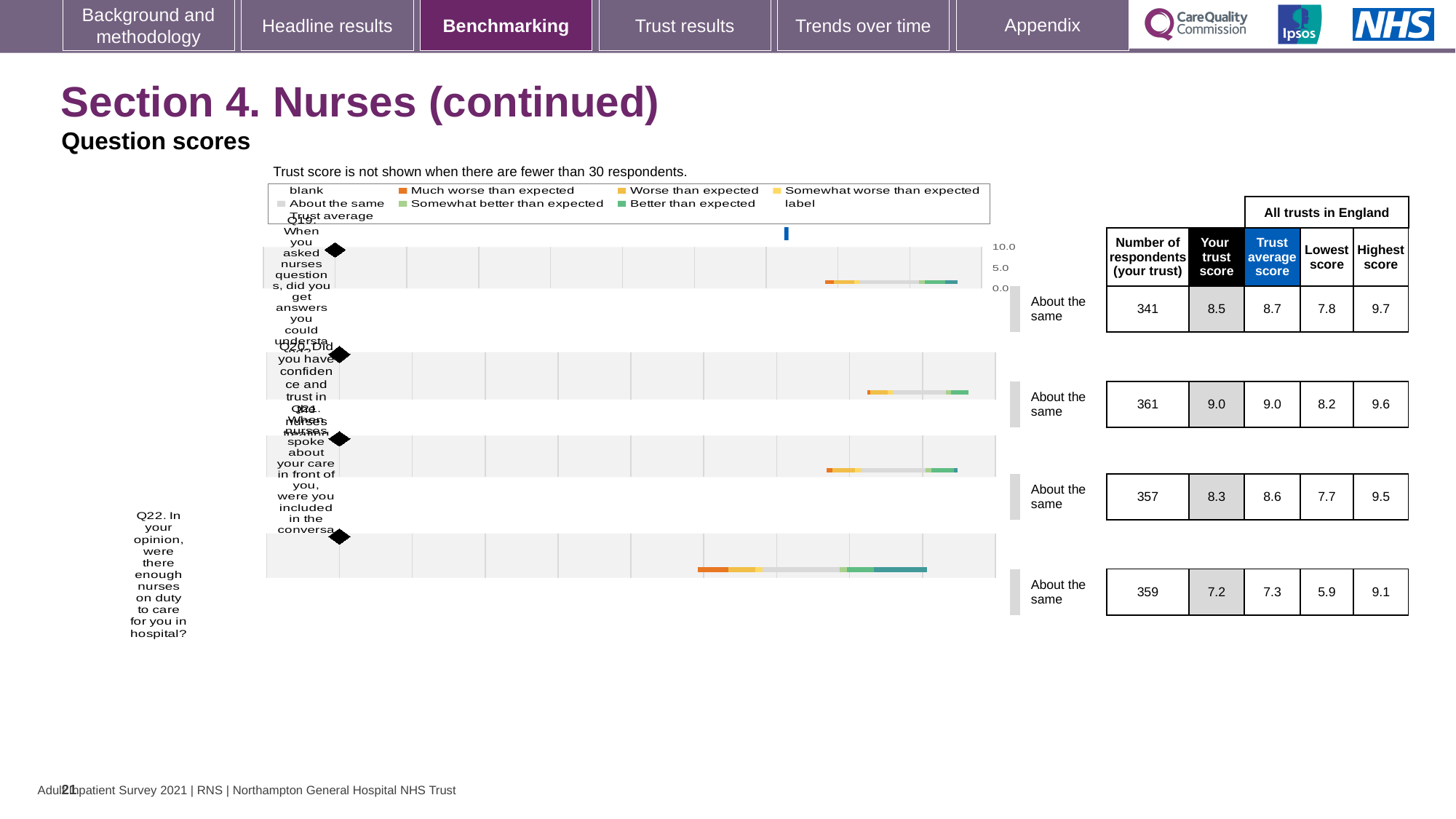
What is the difference between the highest score and the lowest score for Q22? 3.2 Which question has the lowest 'Your trust score'? Q22 In the legend, what colour represents 'Much worse than expected'? orange What is the 'Trust average score' for Q19 (answers you could understand)? 8.7 What is 'Your trust score' for Q22 (enough nurses on duty)? 7.2 For Q19, which is larger: 'Your trust score' or the 'Trust average score'? Trust average score How many questions (rows) are plotted on the chart? 4 In the legend, what colour represents 'Better than expected'? green What kind of chart is shown on the slide? bar chart What is the 'Highest score' for Q19 (answers you could understand)? 9.7 What is the number of respondents for Q22 (enough nurses on duty)? 359 What benchmark category is shown for Q22? About the same